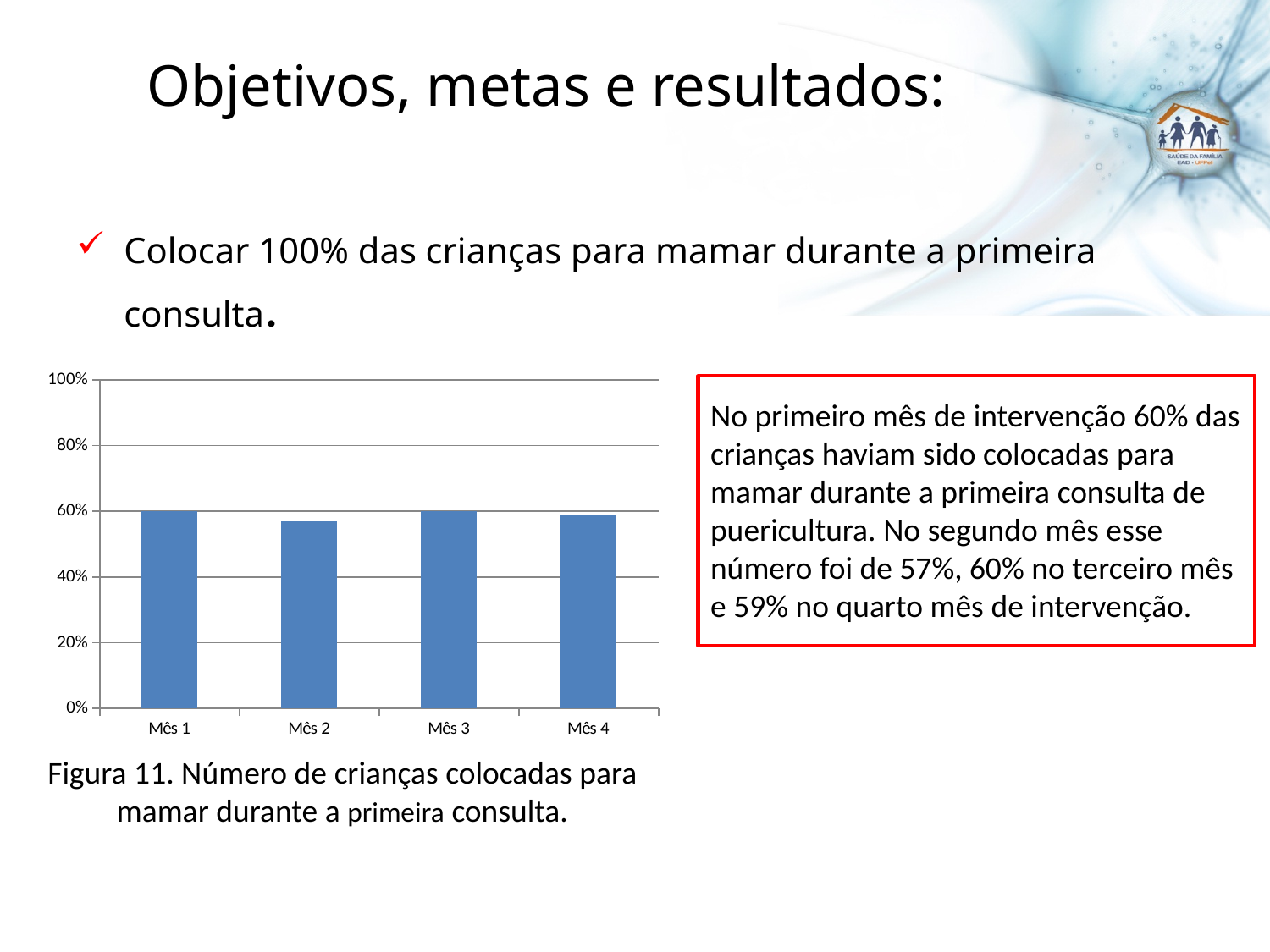
Is the value for Mês 2 greater or less than 60%? less Does the value rise or fall from Mês 1 to Mês 2? Fall How many categories (months) are shown on the x axis? 4 What is the figure number given in the caption below the chart? Figura 11 What is the value for Mês 3? 60% What is the difference between the values for Mês 1 and Mês 2? 3 percentage points What kind of chart is shown on the slide? Bar chart What is the value for Mês 1? 60% What is the value for Mês 2? 57% Which of Mês 1 and Mês 2 has the larger value? Mês 1 Is the value for Mês 4 greater or less than 40%? greater What is the value for Mês 4? 59%